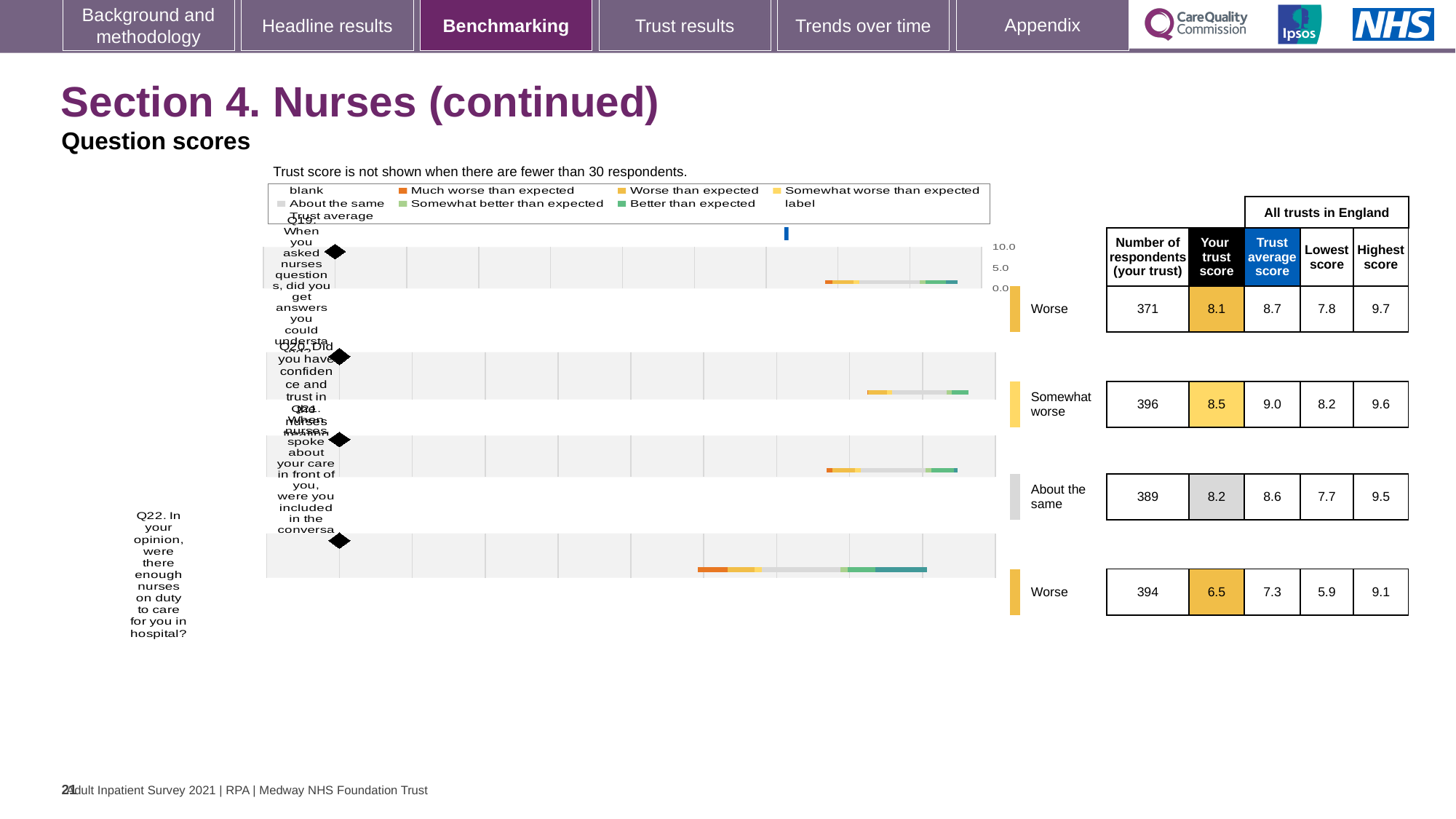
How many questions are plotted on the chart? 4 How many respondents from your trust answered Q20 (did you have confidence and trust in the nurses)? 396 Which question has the lowest 'Your trust score'? Q22 Which benchmark category is shown for Q21 (were you included in the conversation when nurses spoke about your care)? About the same What is the trust average score for all trusts in England for Q19? 8.7 What is the highest score across all trusts in England for Q22? 9.1 Is your trust score for Q22 greater or less than 5.0? greater What is the 'Your trust score' for Q22 (were there enough nurses on duty to care for you in hospital)? 6.5 What kind of chart is used to show the question scores? Bar chart Which has the higher 'Your trust score', Q20 or Q21? Q20 Which question has the highest number of respondents from your trust? Q20 For Q22, what is the difference between the trust average score (7.3) and your trust score (6.5)? 0.8